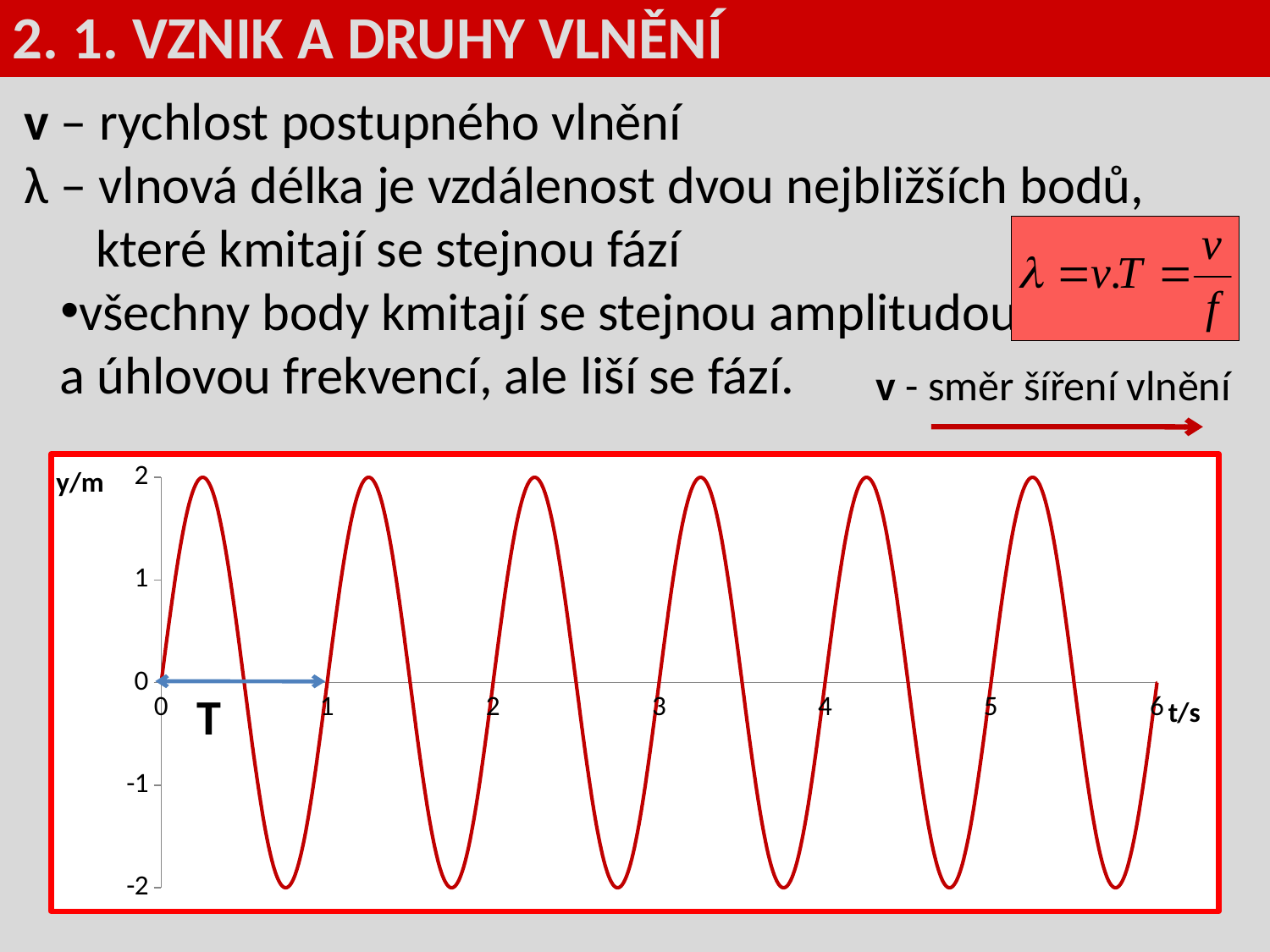
What is the highest value reached by the curve on the y/m axis? 2 Is the value of y at the first trough of the curve greater or less than -1? less What is the value of y at t = 0 s? 0 How many full peaks (maxima) does the curve show between t = 0 and t = 6 s? 6 Does the curve rise or fall between t = 0 s and its first peak? rise What is the label of the horizontal axis of the chart? t/s What is the value of y at t = 1 s? 0 Is the value of y at the first peak of the curve greater or less than 1? greater What is the label of the vertical axis of the chart? y/m What is the lowest value reached by the curve on the y/m axis? -2 What kind of chart is shown on the slide? line chart According to the arrow marked T on the chart, how long is one period T in seconds? 1